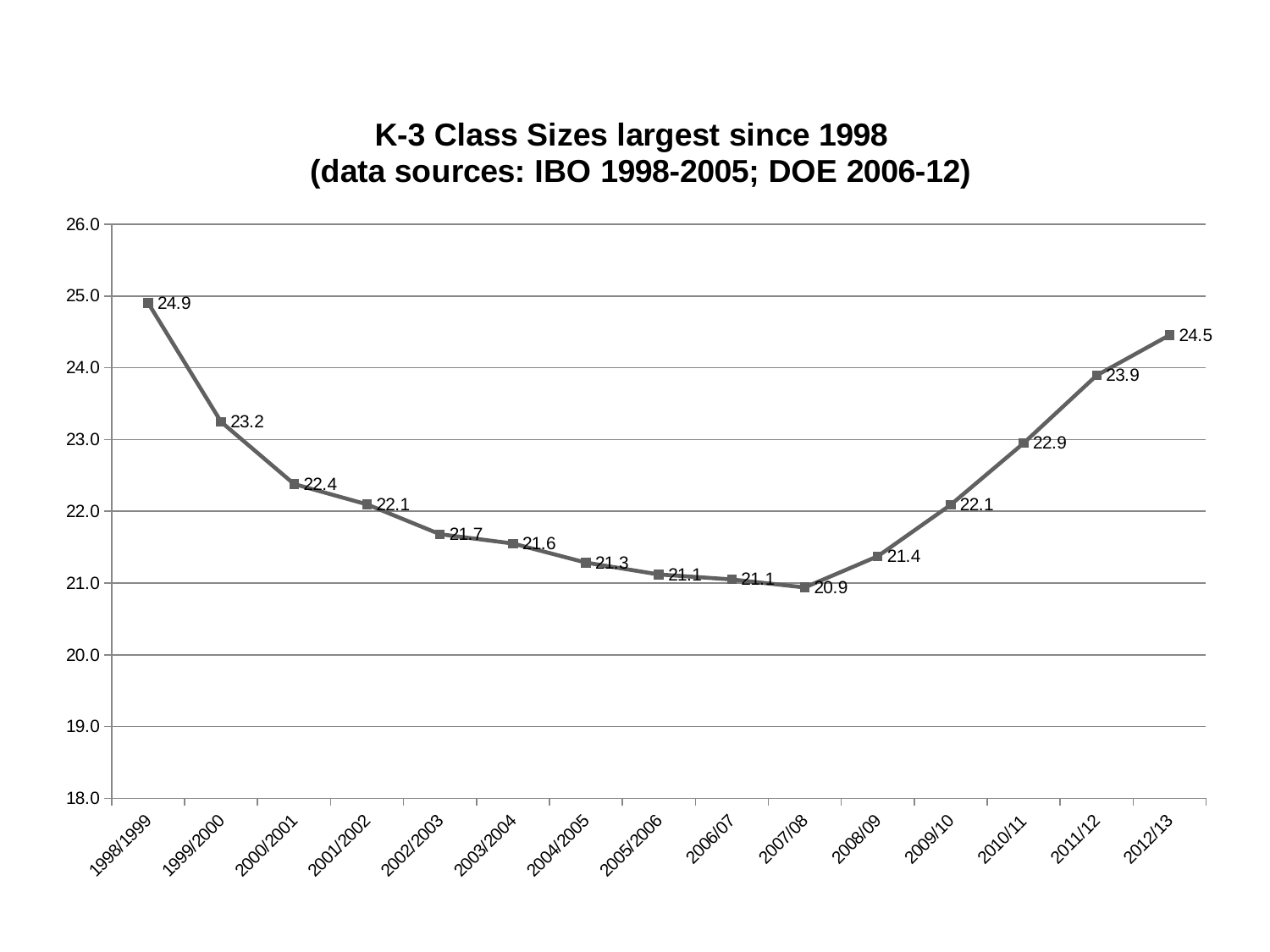
What is the difference between the class size in 1998/1999 and in 2007/08? 4.0 Does the class size rise or fall from 2007/08 to 2012/13? rise What is the K-3 class size for 2007/08? 20.9 Which is larger, the class size in 1999/2000 or in 2010/11? 1999/2000 What is the K-3 class size for 2002/2003? 21.7 Which school year has the highest K-3 class size? 1998/1999 Which school year has the lowest K-3 class size? 2007/08 How many school years are plotted on the chart? 15 What is the difference between the class size in 2012/13 and in 2011/12? 0.6 What kind of chart is shown on the slide? line chart What is the K-3 class size for 2012/13? 24.5 What is the title of the chart? K-3 Class Sizes largest since 1998 (data sources: IBO 1998-2005; DOE 2006-12)